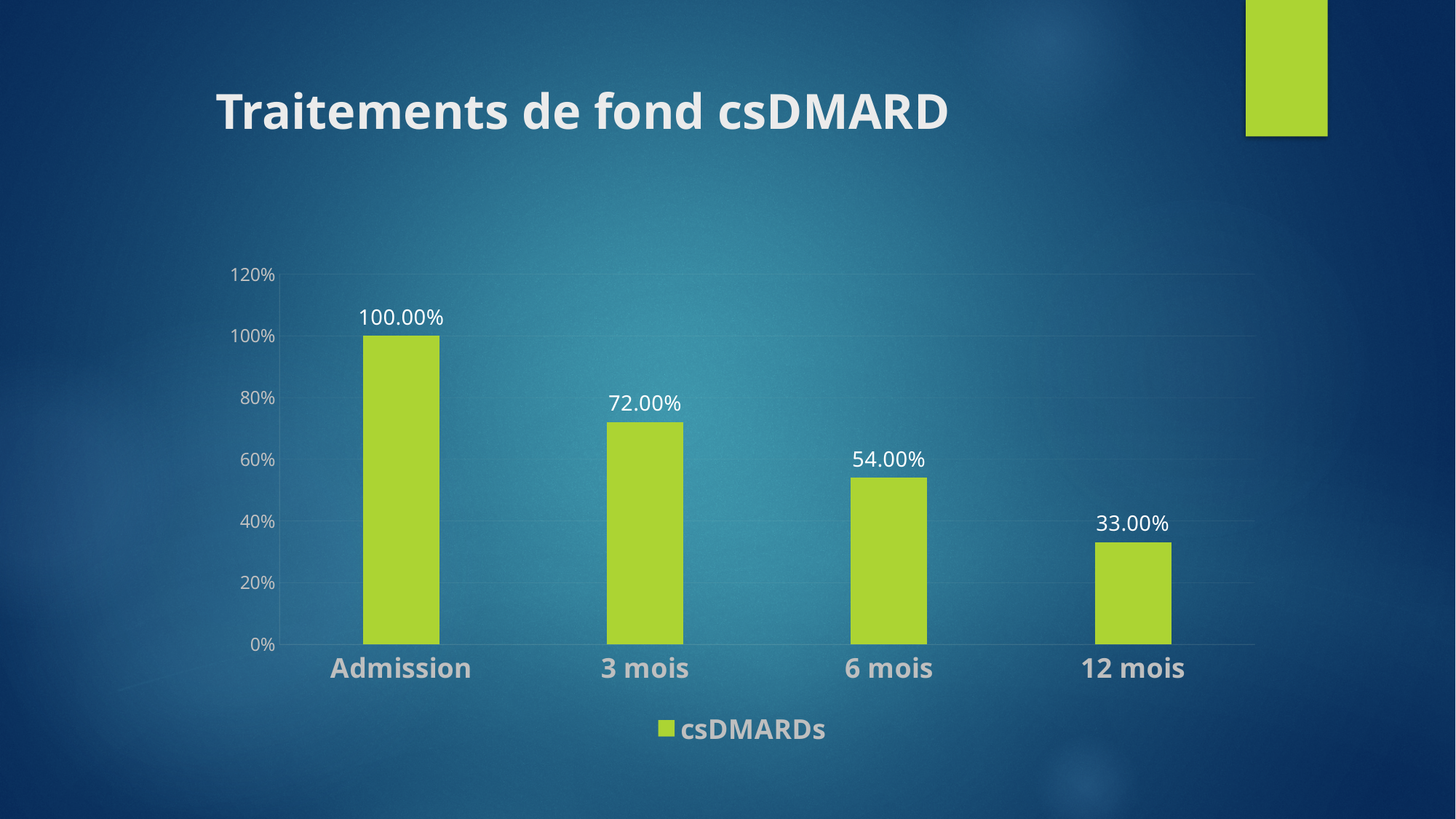
How many categories are shown on the x axis? 4 What is the difference between the values for Admission and 6 mois? 46.00% Which category has the lowest value? 12 mois How many series does the legend list? 1 Is the value for 6 mois greater or less than 60%? less Which category has the highest value? Admission What is the value for 3 mois? 72.00% What is the value for 6 mois? 54.00% Do the values rise or fall from Admission to 12 mois? fall What is the value for 12 mois? 33.00% What kind of chart is shown? bar chart Which is larger, the value for 3 mois or the value for 12 mois? 3 mois